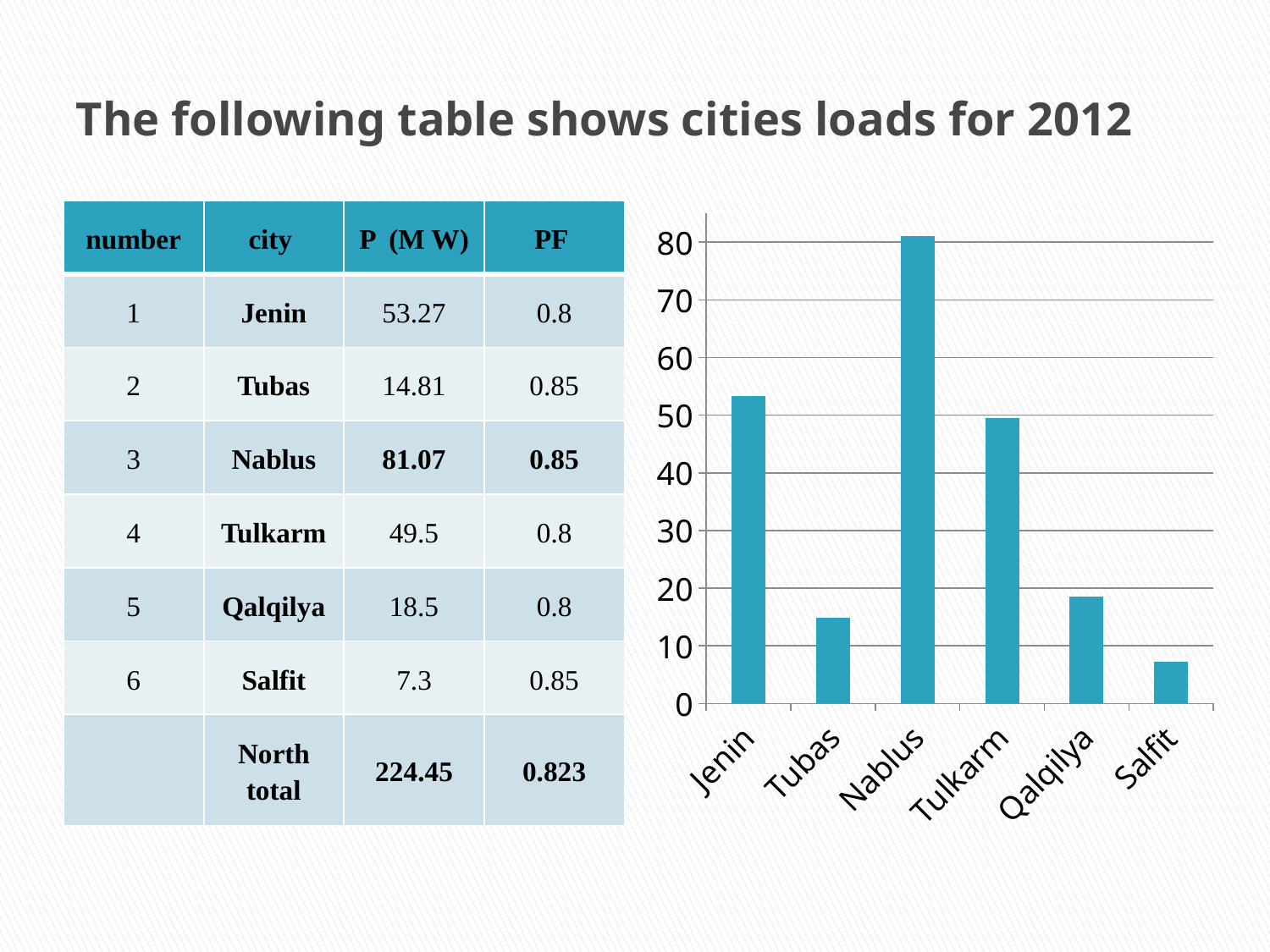
In the chart, which bar is taller: Nablus or Jenin? Nablus What kind of chart is shown on the right of the slide? bar chart According to the table, what is the load P (MW) for Nablus? 81.07 Which city has the tallest bar in the chart? Nablus Is the value for Tubas in the chart greater or less than 20? less How many cities are plotted as bars in the chart? 6 In the chart, which bar is taller: Qalqilya or Tubas? Qalqilya Is the value for Nablus in the chart greater or less than 70? greater According to the table, what is the load P (MW) for Jenin? 53.27 Using the table values, what is the difference in P (MW) between Nablus and Jenin? 27.8 Is the value for Salfit in the chart greater or less than 10? less Which city has the shortest bar in the chart? Salfit